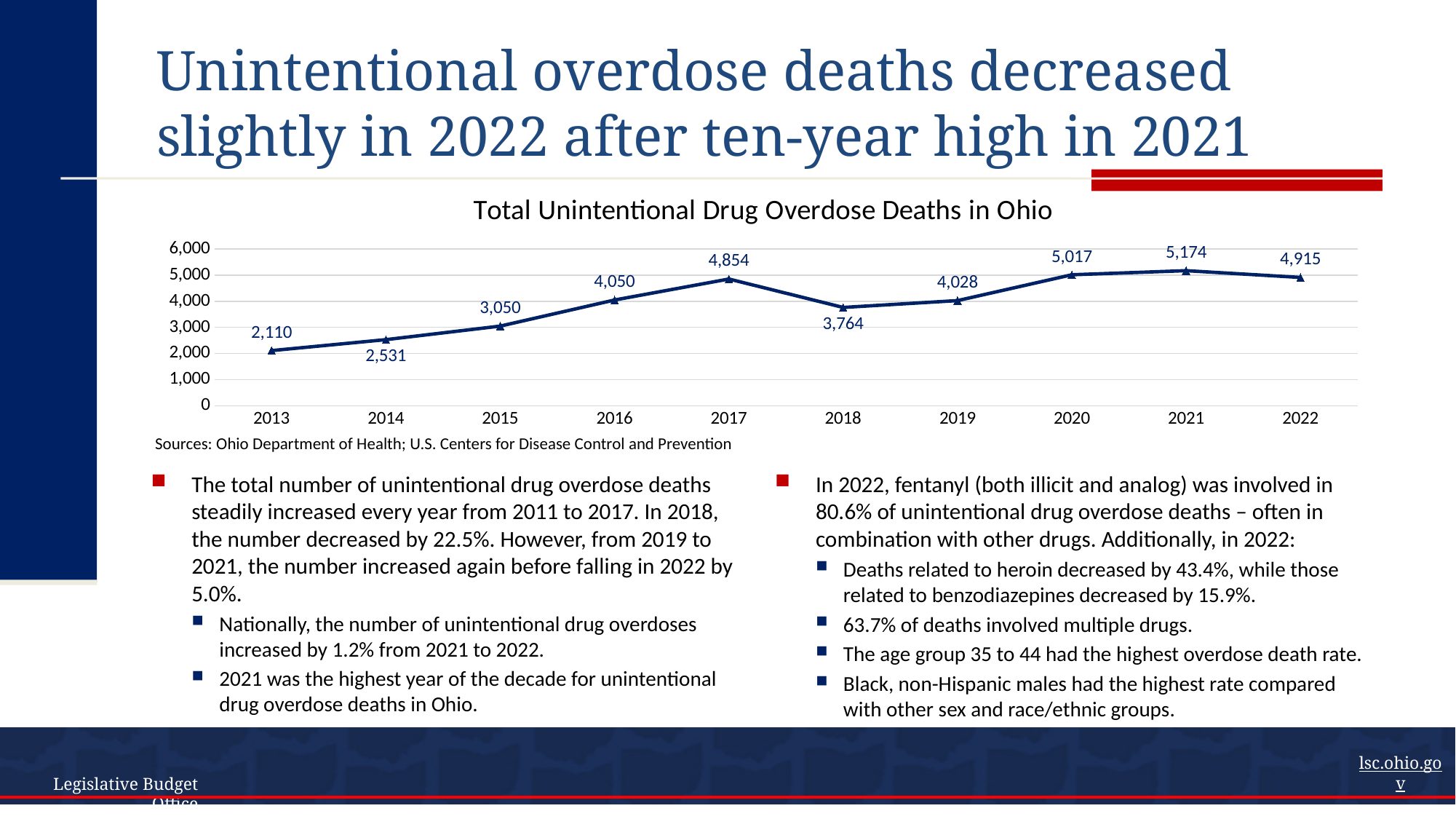
Which is larger, the value for 2017 or the value for 2019? 2017 How many years are plotted in the chart? 10 What is the value for 2013 in the Total Unintentional Drug Overdose Deaths in Ohio chart? 2,110 Which year has the lowest value in the chart? 2013 What is the value for 2018 in the chart? 3,764 What is the value for 2022 in the chart? 4,915 Which year has the highest value in the chart? 2021 What is the difference between the values for 2021 and 2022? 259 What kind of chart is shown on the slide? line chart Is the value for 2016 greater or less than 3,000? greater What is the title of the chart? Total Unintentional Drug Overdose Deaths in Ohio What is the difference between the values for 2017 and 2018? 1,090